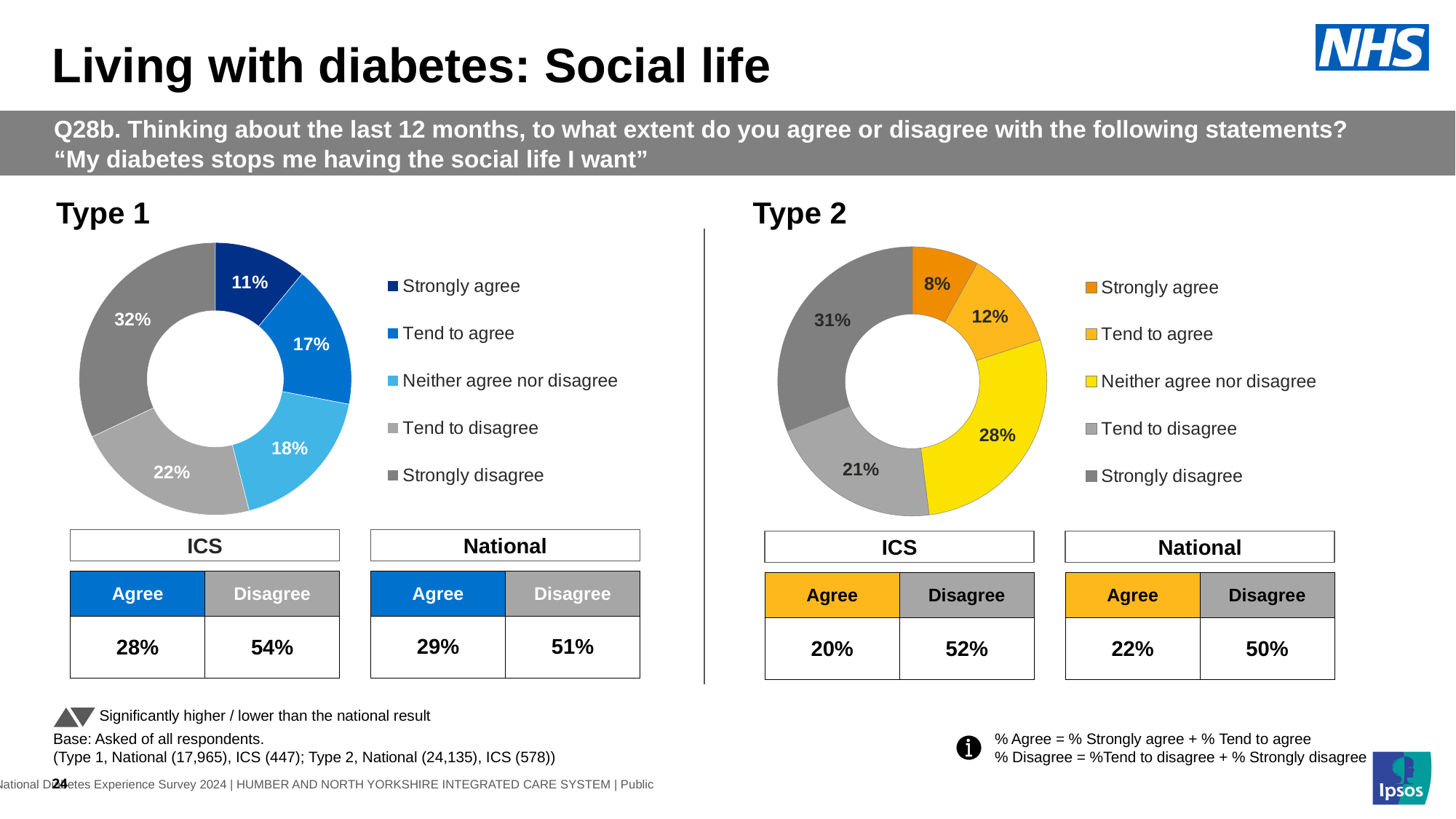
In the Type 1 chart, what is the combined share of 'Strongly agree' and 'Tend to agree'? 28% How many response categories are shown in the Type 2 chart? 5 In the Type 1 chart, what percentage of respondents said 'Strongly agree'? 11% In the Type 2 chart, what percentage of respondents said 'Neither agree nor disagree'? 28% In the Type 1 chart, what is the difference between the 'Strongly disagree' and 'Tend to disagree' shares? 10 percentage points In the Type 1 chart, what percentage of respondents said 'Tend to disagree'? 22% In the Type 2 chart, what is the combined share of 'Tend to disagree' and 'Strongly disagree'? 52% In the Type 2 chart, which response category has the smallest share? Strongly agree In the Type 2 chart, which is larger: 'Tend to agree' or 'Tend to disagree'? Tend to disagree In the Type 1 chart, which response category has the largest share? Strongly disagree What colour represents 'Strongly agree' in the Type 2 chart? Orange What kind of chart is used for the Type 1 data? Doughnut chart